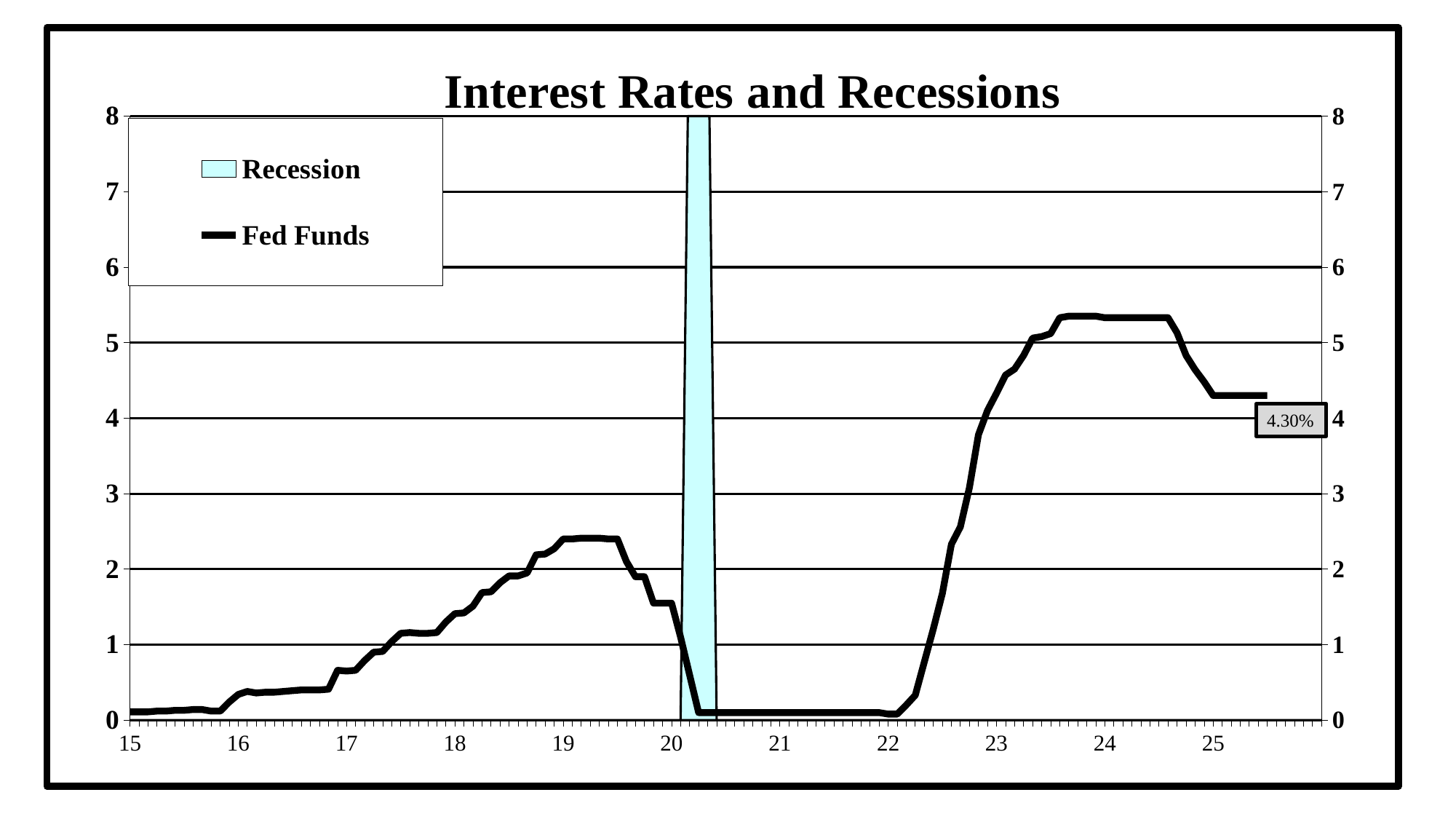
Does the Fed Funds line rise or fall between year 24.5 and year 25? fall Is the Fed Funds value at year 16 greater or less than 1? less What is the title of the chart? Interest Rates and Recessions Is the Fed Funds value at year 24 greater or less than 5? greater Around which year on the x axis is the shaded Recession band located? 20 Is the Fed Funds value at year 21 greater or less than 1? less Which is larger, the Fed Funds value at year 24 or at year 19? year 24 How many entries does the legend list? 2 Does the Fed Funds line rise or fall between year 22 and year 23? rise What kind of chart is shown on the slide? line chart What value is printed on the data label at the end of the Fed Funds line? 4.30%